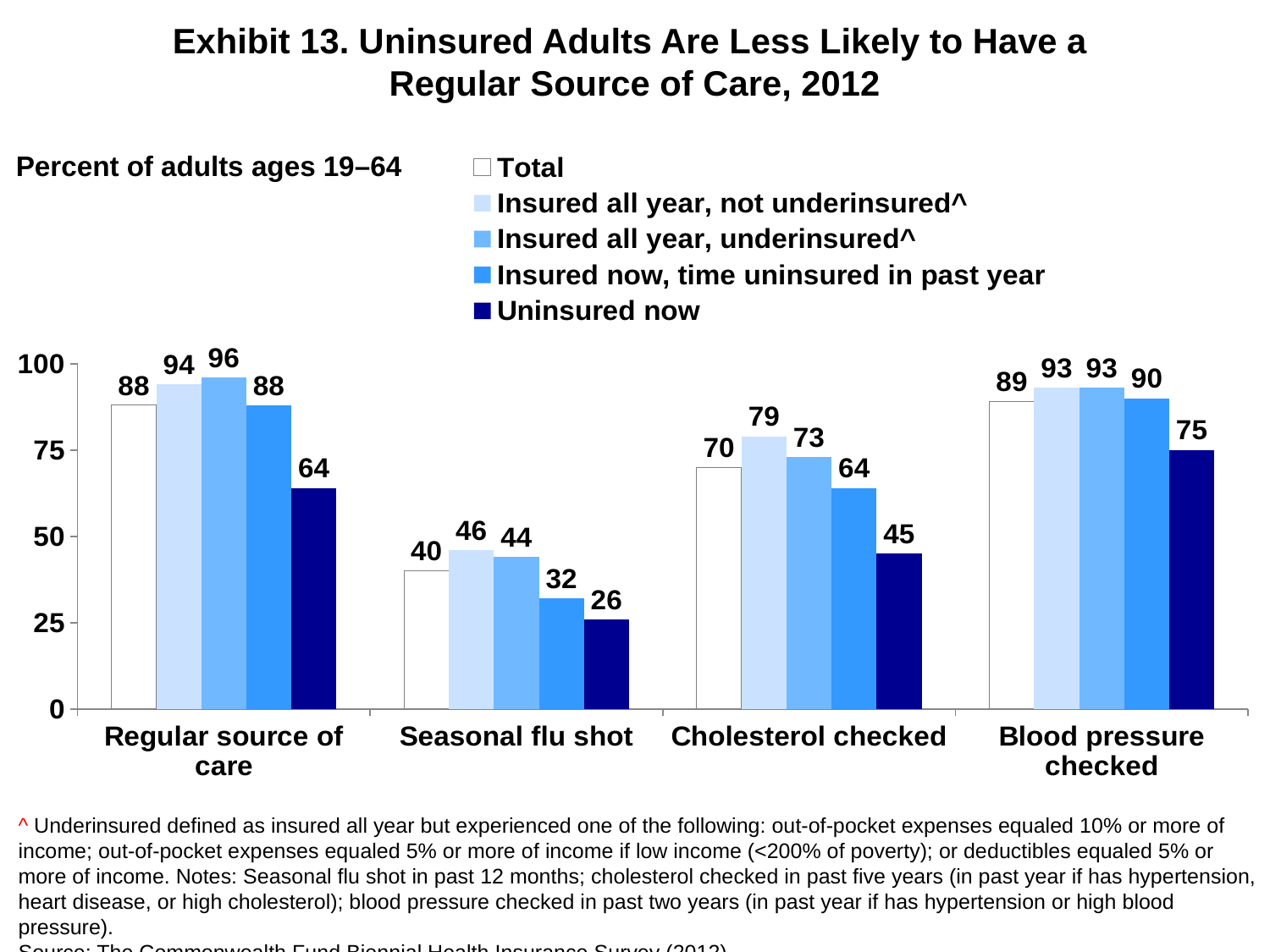
What is the value for Total in the Seasonal flu shot category? 40 Which is larger in the Cholesterol checked category: Insured all year, underinsured or Insured now, time uninsured in past year? Insured all year, underinsured What is the title of the chart? Exhibit 13. Uninsured Adults Are Less Likely to Have a Regular Source of Care, 2012 What is the difference between the Insured all year, underinsured value and the Uninsured now value in the Seasonal flu shot category? 18 How many series does the legend list? 5 What is the value for Insured all year, not underinsured in the Cholesterol checked category? 79 Which series has the lowest value in the Blood pressure checked category? Uninsured now What is the value for Uninsured now in the Regular source of care category? 64 Which category has the highest value for the Total series? Blood pressure checked What kind of chart is shown on the slide? bar chart How many categories are shown on the x axis? 4 What is the difference between the Total value for Regular source of care and the Total value for Seasonal flu shot? 48